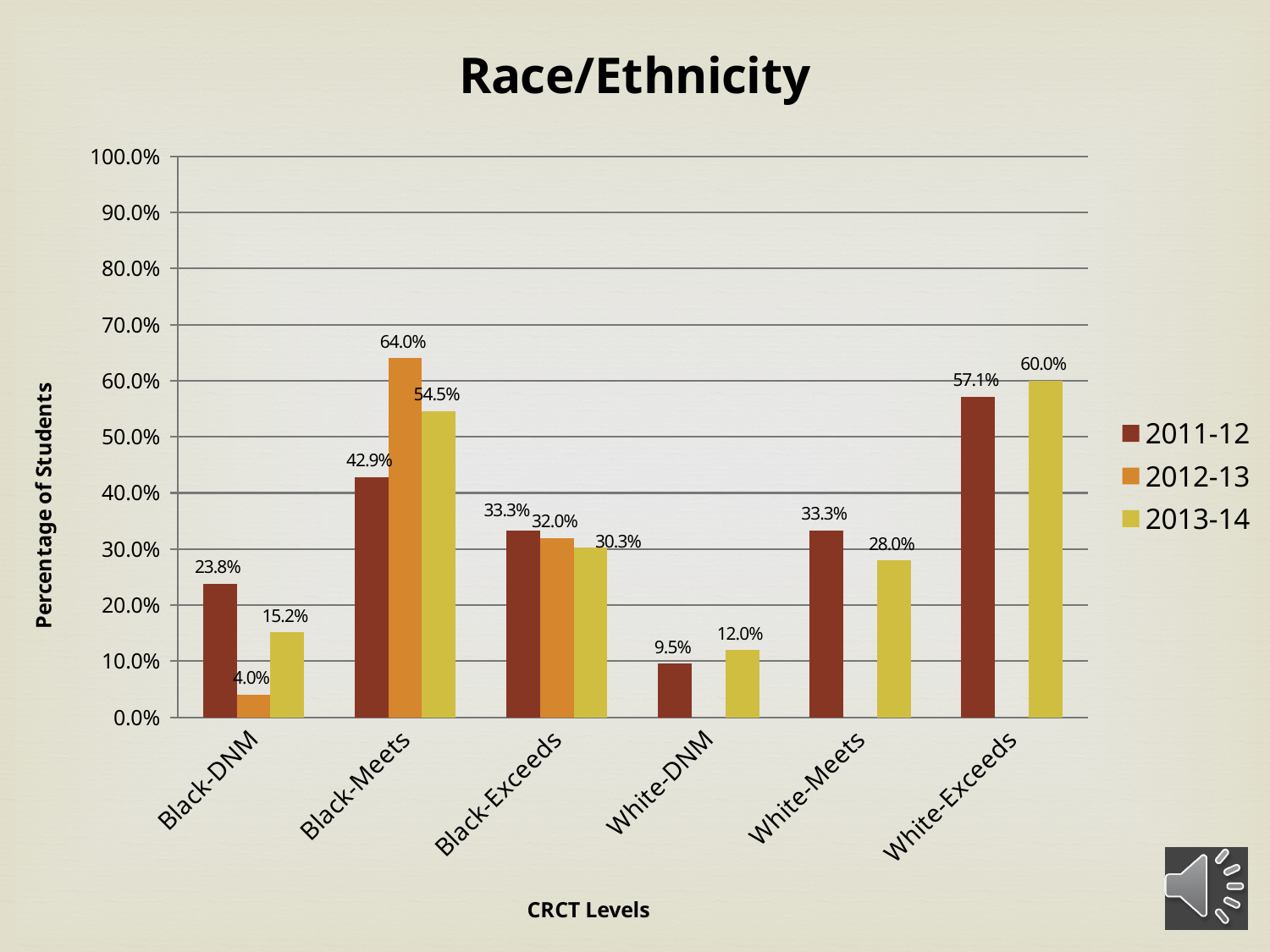
What is the value for Black-Meets in the 2012-13 series? 64.0% What is the difference between the 2011-12 and 2013-14 values for Black-DNM? 8.6% What is the title of the chart? Race/Ethnicity How many categories are shown on the x axis? 6 What is the value for White-Exceeds in the 2013-14 series? 60.0% Is the 2013-14 value for Black-Meets greater or less than 50.0%? greater How many series does the legend list? 3 Which category has the highest value in the 2011-12 series? White-Exceeds What is the value for Black-DNM in the 2012-13 series? 4.0% What kind of chart is shown on the slide? bar chart Which category has the lowest value in the 2013-14 series? White-DNM Which is larger: the 2011-12 value for White-Meets or the 2013-14 value for White-Meets? 2011-12